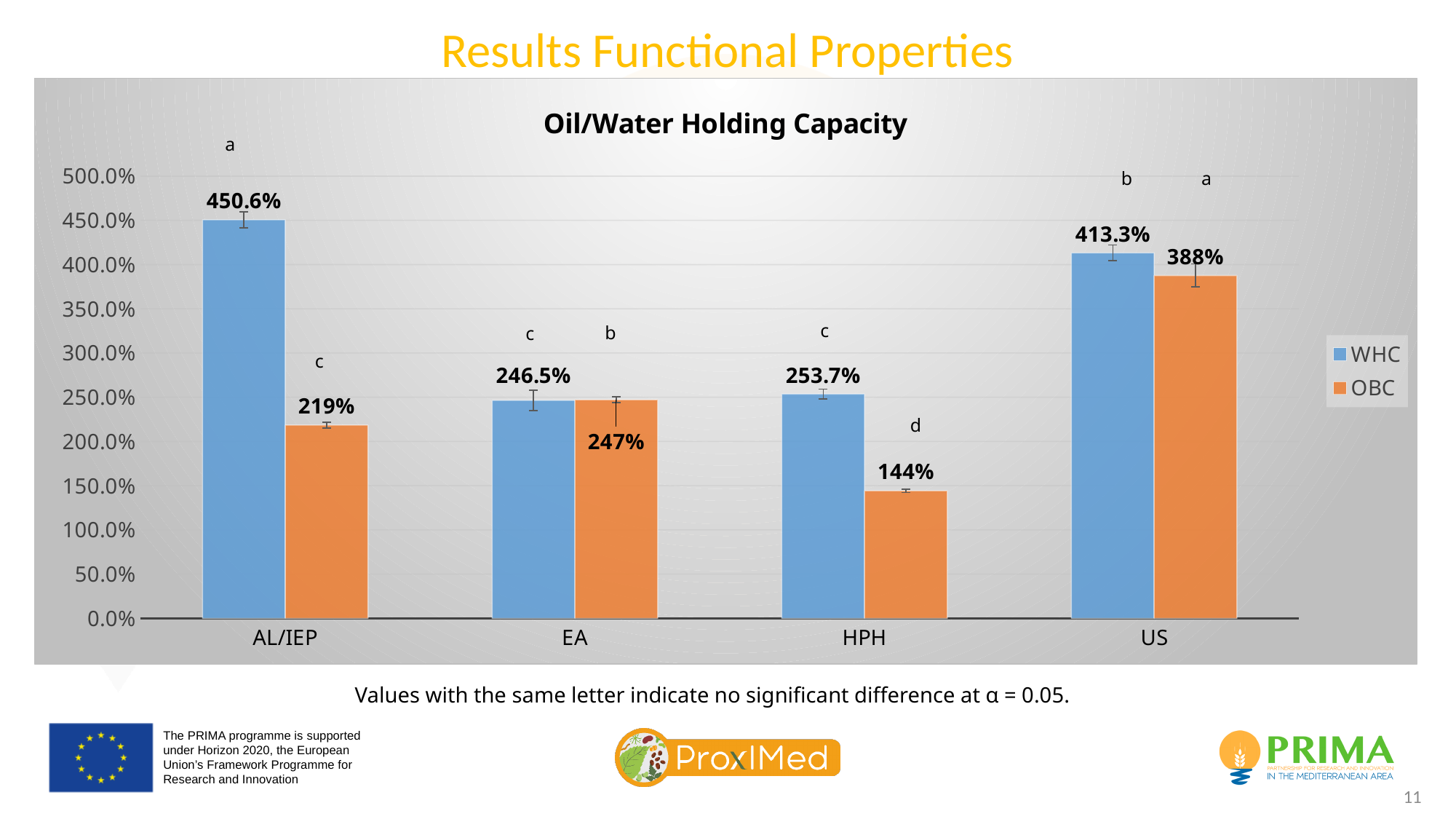
What is the WHC value for EA? 246.5% How many categories are shown on the x axis? 4 What is the WHC value for AL/IEP? 450.6% Which category has the lowest OBC value? HPH What is the title of the chart? Oil/Water Holding Capacity What is the difference between the WHC and OBC values for AL/IEP? 231.6% What is the OBC value for US? 388% Which category has the highest WHC value? AL/IEP What kind of chart is shown? Bar chart Which is larger for HPH, the WHC value or the OBC value? WHC What is the OBC value for HPH? 144% How many series does the legend list? 2